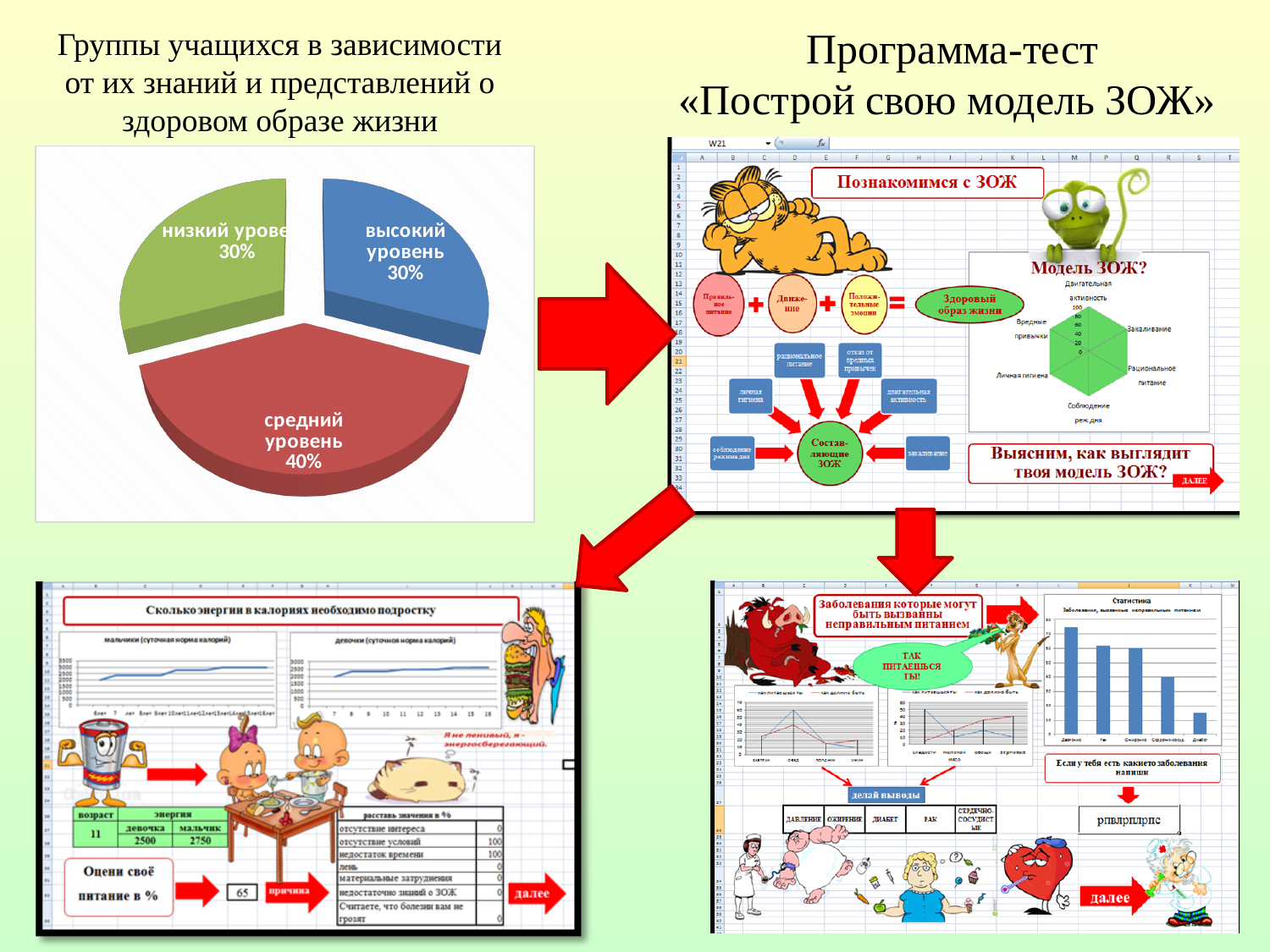
What kind of chart is shown on the left of the slide under the heading about groups of students? pie chart In the pie chart on the left of the slide, what is the combined share of the низкий уровень and высокий уровень slices? 60% In the pie chart on the left of the slide, which group has the largest share? средний уровень In the pie chart on the left of the slide, what share of students is in the высокий уровень group? 30% In the pie chart on the left of the slide, what share of students is in the низкий уровень group? 30% In the pie chart on the left of the slide, what colour is the высокий уровень slice? blue In the pie chart on the left of the slide, what share of students is in the средний уровень group? 40% In the pie chart on the left of the slide, do the низкий уровень and высокий уровень slices have the same share? yes In the pie chart on the left of the slide, what is the difference in percentage points between the средний уровень and высокий уровень slices? 10 In the pie chart on the left of the slide, how many slices are there? 3 In the pie chart on the left of the slide, which slice is larger: средний уровень or низкий уровень? средний уровень In the pie chart on the left of the slide, what colour is the средний уровень slice? red